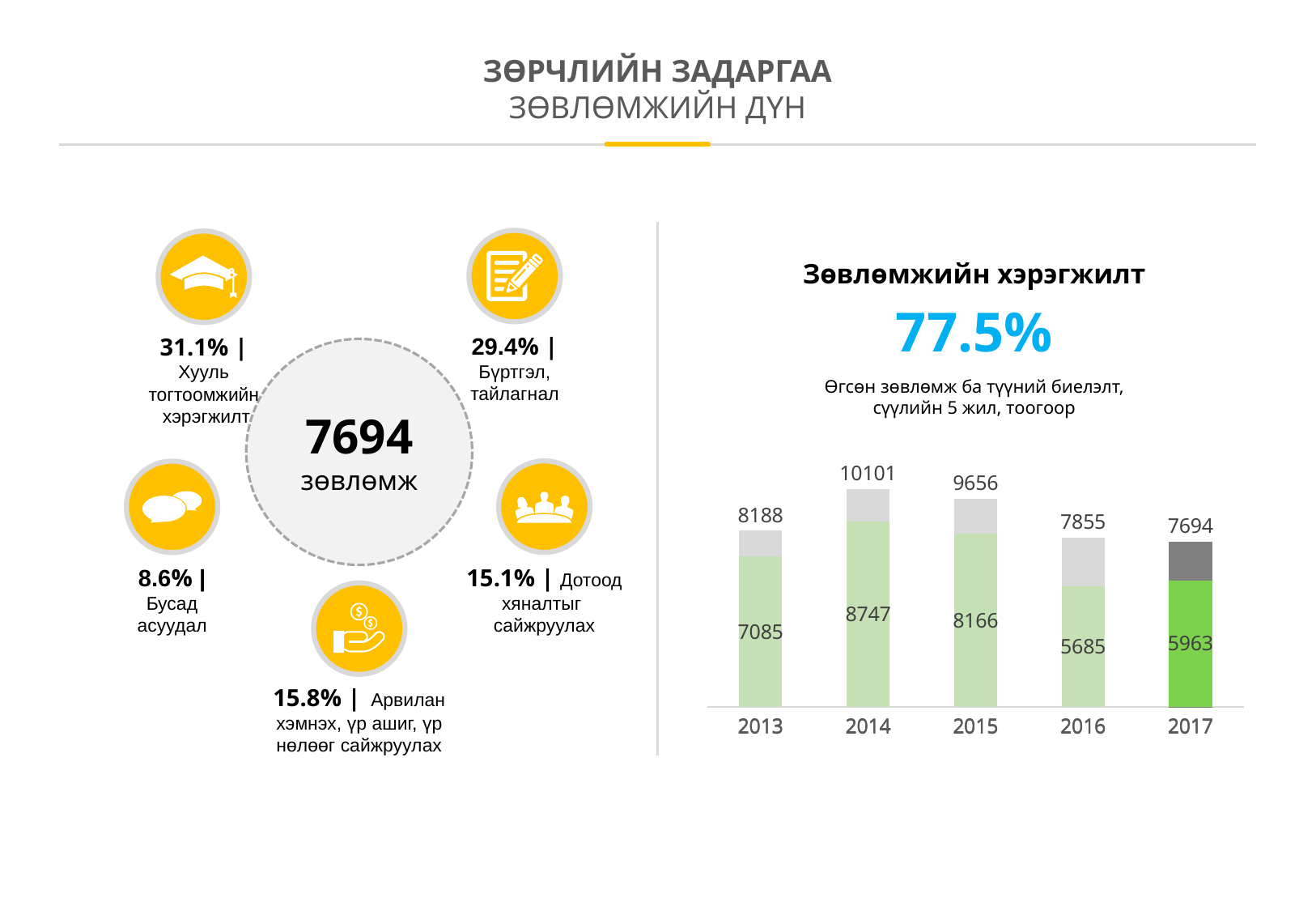
In the bar chart on the right, which year has the highest total? 2014 How many years are shown on the x axis of the bar chart on the right? 5 In the bar chart on the right, what is the total value shown above the bar for 2014? 10101 In the bar chart on the right, which year's bar is coloured differently (bright green and dark grey) from the others? 2017 In the bar chart on the right, what is the value of the upper segment of the 2017 bar (total minus the lower segment)? 1731 In the bar chart on the right, what value is printed inside the lower (green) segment of the 2016 bar? 5685 In the bar chart on the right, what is the difference between the total for 2014 and the total for 2013? 1913 In the bar chart on the right, which is larger: the lower segment value for 2015 or for 2016? 2015 In the bar chart on the right, which year has the lowest total? 2017 What kind of chart is shown on the right side of the slide? Stacked bar chart In the bar chart on the right, what value is printed inside the lower segment of the 2013 bar? 7085 In the bar chart on the right, do the totals rise or fall from 2014 to 2017? Fall